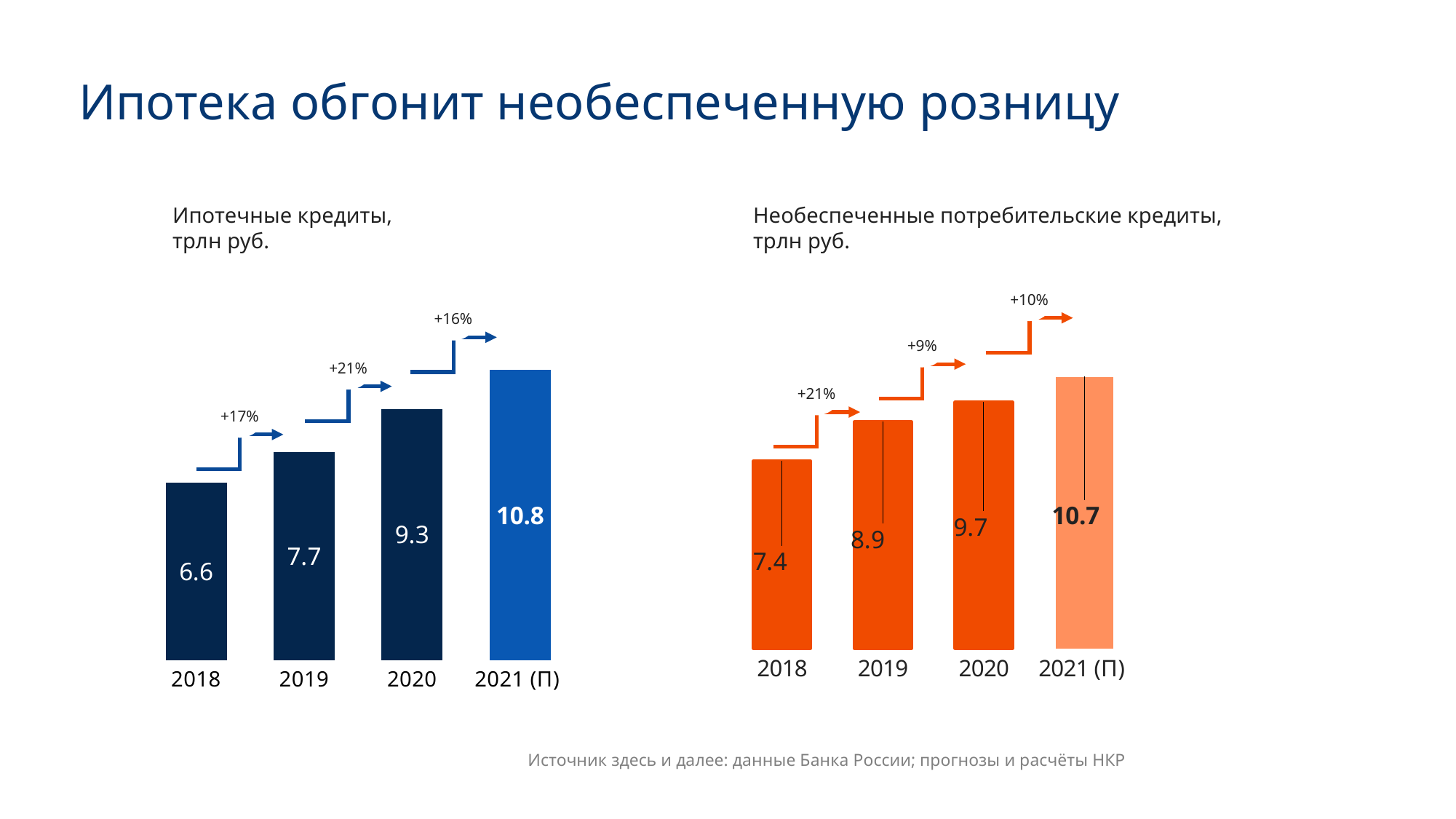
What is the title of the slide? Ипотека обгонит необеспеченную розницу In the left chart (Ипотечные кредиты), what percentage growth is shown between 2019 and 2020? +21% In the right chart (Необеспеченные потребительские кредиты), do the values rise or fall from 2018 to 2021 (П)? Rise In the left chart (Ипотечные кредиты), which year has the highest value? 2021 (П) In the right chart (Необеспеченные потребительские кредиты), what is the difference between the 2019 value and the 2018 value? 1.5 In the left chart (Ипотечные кредиты, трлн руб.), what is the value for 2019? 7.7 In the right chart (Необеспеченные потребительские кредиты), which year has the lowest value? 2018 In the left chart (Ипотечные кредиты), what is the difference between the 2021 (П) value and the 2018 value? 4.2 What type of chart is the right chart (Необеспеченные потребительские кредиты)? Bar chart Which is larger for 2021 (П): the value in the left chart (Ипотечные кредиты) or the value in the right chart (Необеспеченные потребительские кредиты)? Ипотечные кредиты (10.8) In the left chart (Ипотечные кредиты), how many years are shown on the x axis? 4 In the right chart (Необеспеченные потребительские кредиты, трлн руб.), what is the value for 2020? 9.7